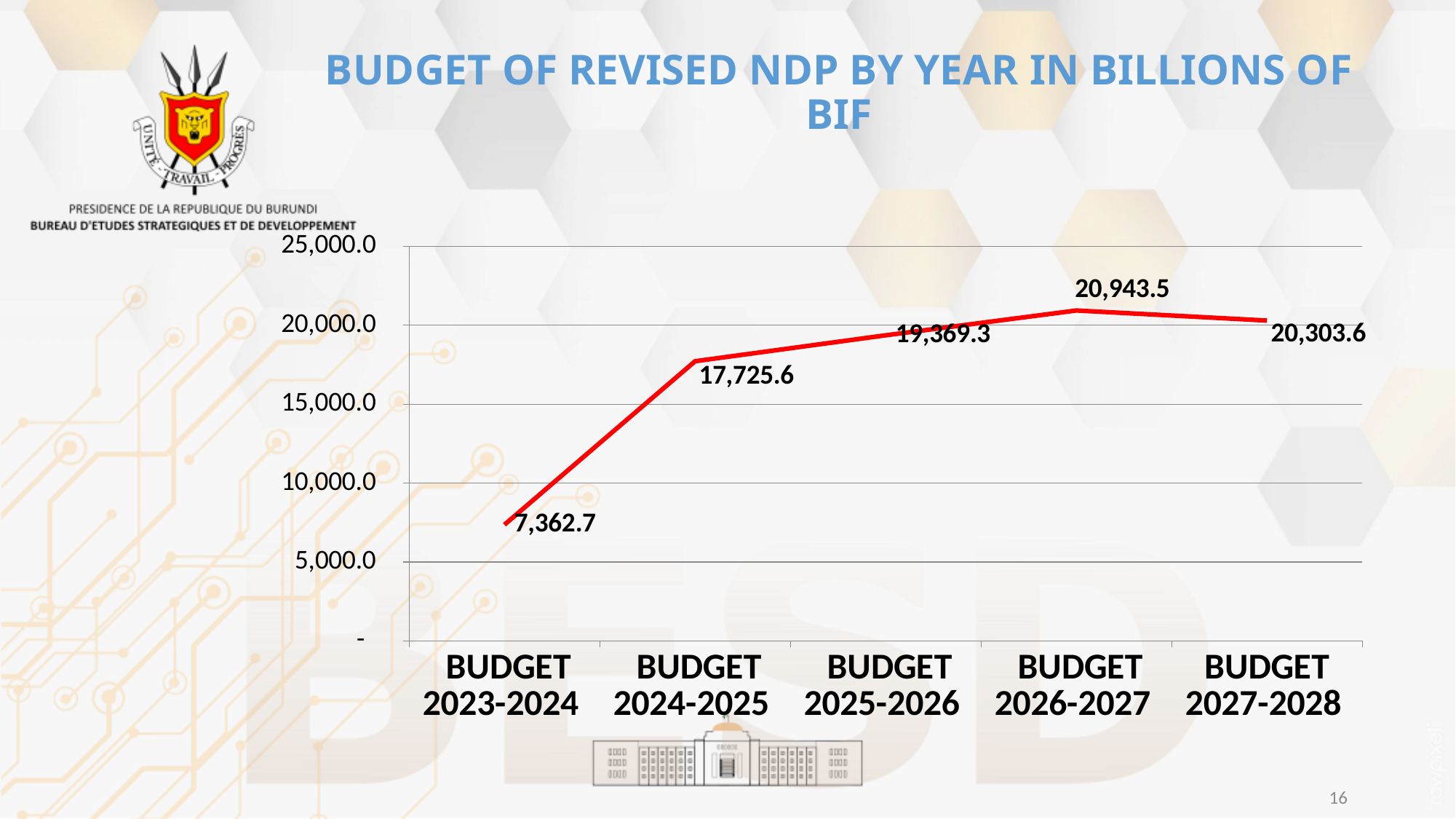
How many budget years are plotted on the chart? 5 Which year has the highest budget? BUDGET 2026-2027 What is the budget for BUDGET 2027-2028? 20,303.6 What is the difference between the budget for 2026-2027 and the budget for 2027-2028? 639.9 Which year has the lowest budget? BUDGET 2023-2024 Is the budget for 2023-2024 greater or less than 10,000.0? less What kind of chart is shown on the slide? line chart What is the budget for BUDGET 2025-2026? 19,369.3 By how much does the budget increase from 2023-2024 to 2024-2025? 10,362.9 Which is larger, the budget for 2024-2025 or the budget for 2025-2026? BUDGET 2025-2026 Does the budget rise or fall from 2023-2024 to 2026-2027? rise What is the budget for BUDGET 2023-2024? 7,362.7